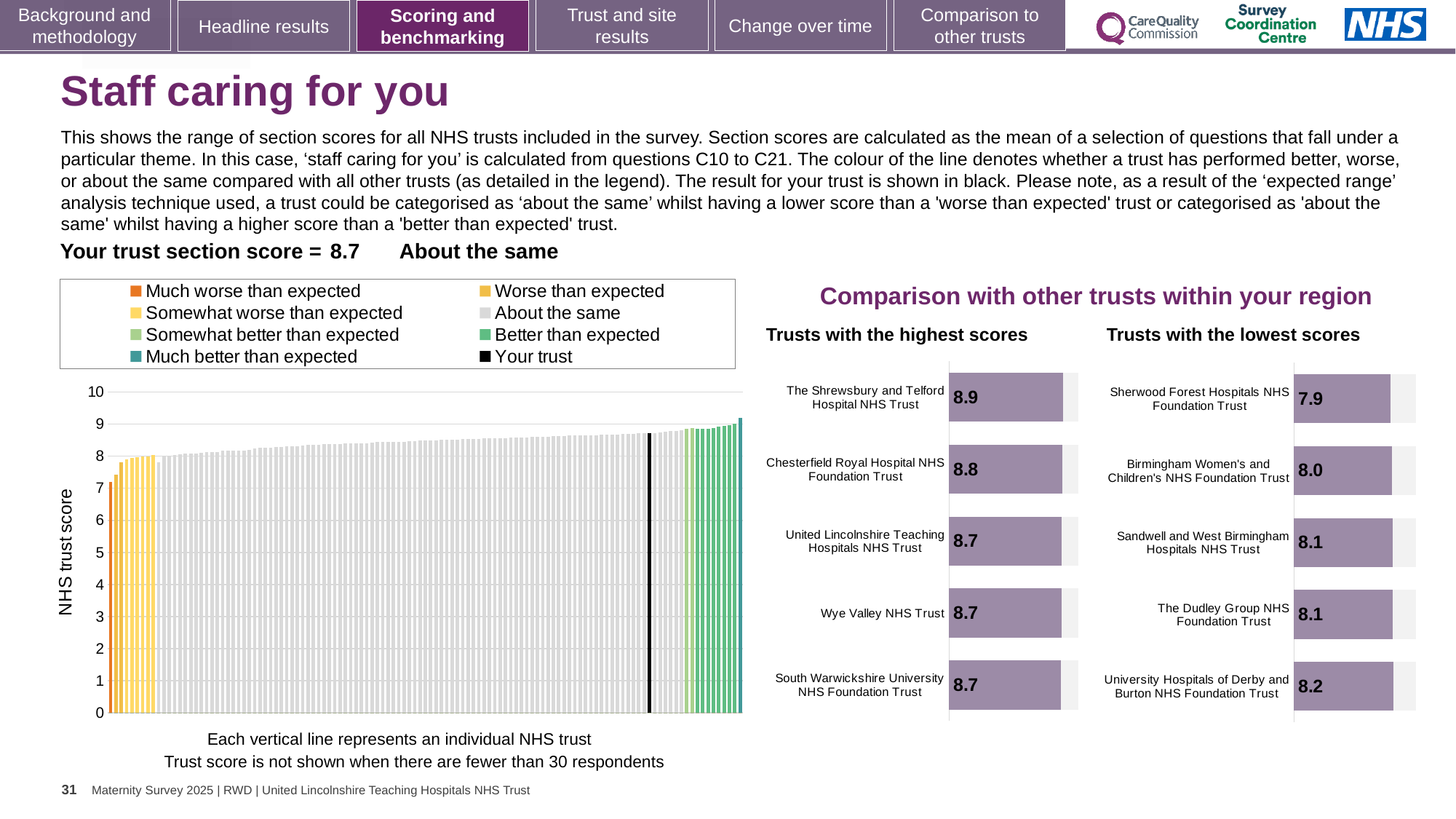
In the 'Trusts with the highest scores' chart, which trust has the highest score? The Shrewsbury and Telford Hospital NHS Trust How many trusts are shown in the 'Trusts with the highest scores' chart? 5 What kind of chart is the main chart on the left showing all NHS trusts? bar chart In the 'Trusts with the lowest scores' chart, which trust has the lowest score? Sherwood Forest Hospitals NHS Foundation Trust How many entries does the legend of the main chart on the left list? 8 In the 'Trusts with the lowest scores' chart, what is the score for The Dudley Group NHS Foundation Trust? 8.1 In the main chart on the left, is the value for the black 'Your trust' bar greater or less than 8? greater In the 'Trusts with the highest scores' chart, which has the higher score: Chesterfield Royal Hospital NHS Foundation Trust or Wye Valley NHS Trust? Chesterfield Royal Hospital NHS Foundation Trust In the 'Trusts with the highest scores' chart, what is the difference between the scores of The Shrewsbury and Telford Hospital NHS Trust and Chesterfield Royal Hospital NHS Foundation Trust? 0.1 In the 'Trusts with the highest scores' chart, what is the score for The Shrewsbury and Telford Hospital NHS Trust? 8.9 In the 'Trusts with the lowest scores' chart, what is the score for Sherwood Forest Hospitals NHS Foundation Trust? 7.9 In the 'Trusts with the lowest scores' chart, what is the difference between the scores of University Hospitals of Derby and Burton NHS Foundation Trust and Sherwood Forest Hospitals NHS Foundation Trust? 0.3